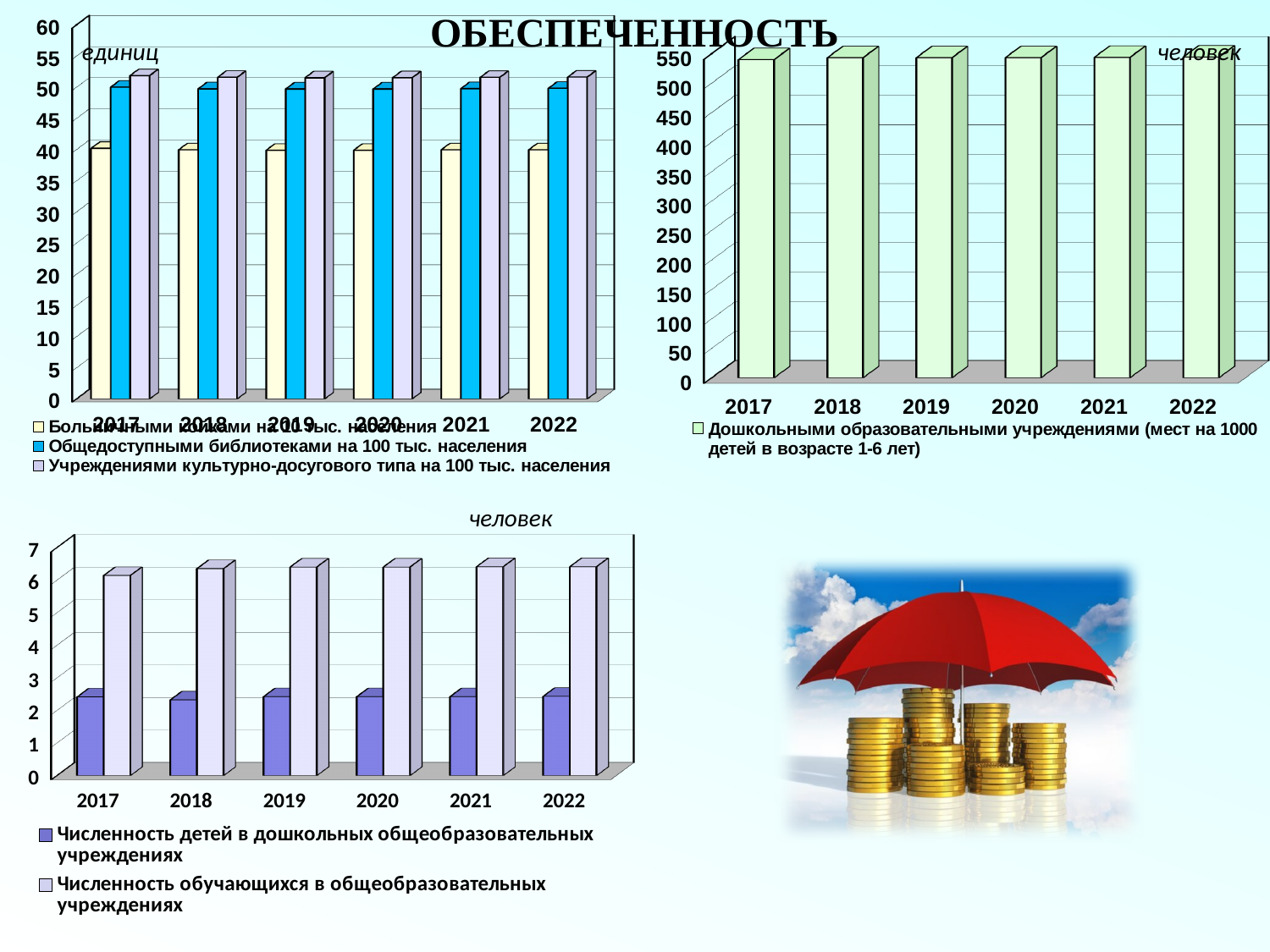
In the top-left chart, is the 2017 value for 'Больничными койками на 10 тыс. населения' greater or less than 45? less In the top-left chart, is the 2020 value for 'Общедоступными библиотеками на 100 тыс. населения' greater or less than 45? greater How many series does the legend of the bottom-left chart list? 2 What kind of chart is the top-left chart on the slide? bar chart In the bottom-left chart, which series has the larger value in 2021: 'Численность обучающихся в общеобразовательных учреждениях' or 'Численность детей в дошкольных общеобразовательных учреждениях'? Численность обучающихся в общеобразовательных учреждениях In the bottom-left chart, is the 2018 value for 'Численность детей в дошкольных общеобразовательных учреждениях' greater or less than 3? less In the top-left chart, which is larger in 2019: 'Общедоступными библиотеками на 100 тыс. населения' or 'Больничными койками на 10 тыс. населения'? Общедоступными библиотеками на 100 тыс. населения How many series does the legend of the top-right chart list? 1 How many series does the legend of the top-left chart list? 3 What unit label is shown at the top of the top-left chart? единиц How many years are shown on the x axis of the top-left chart? 6